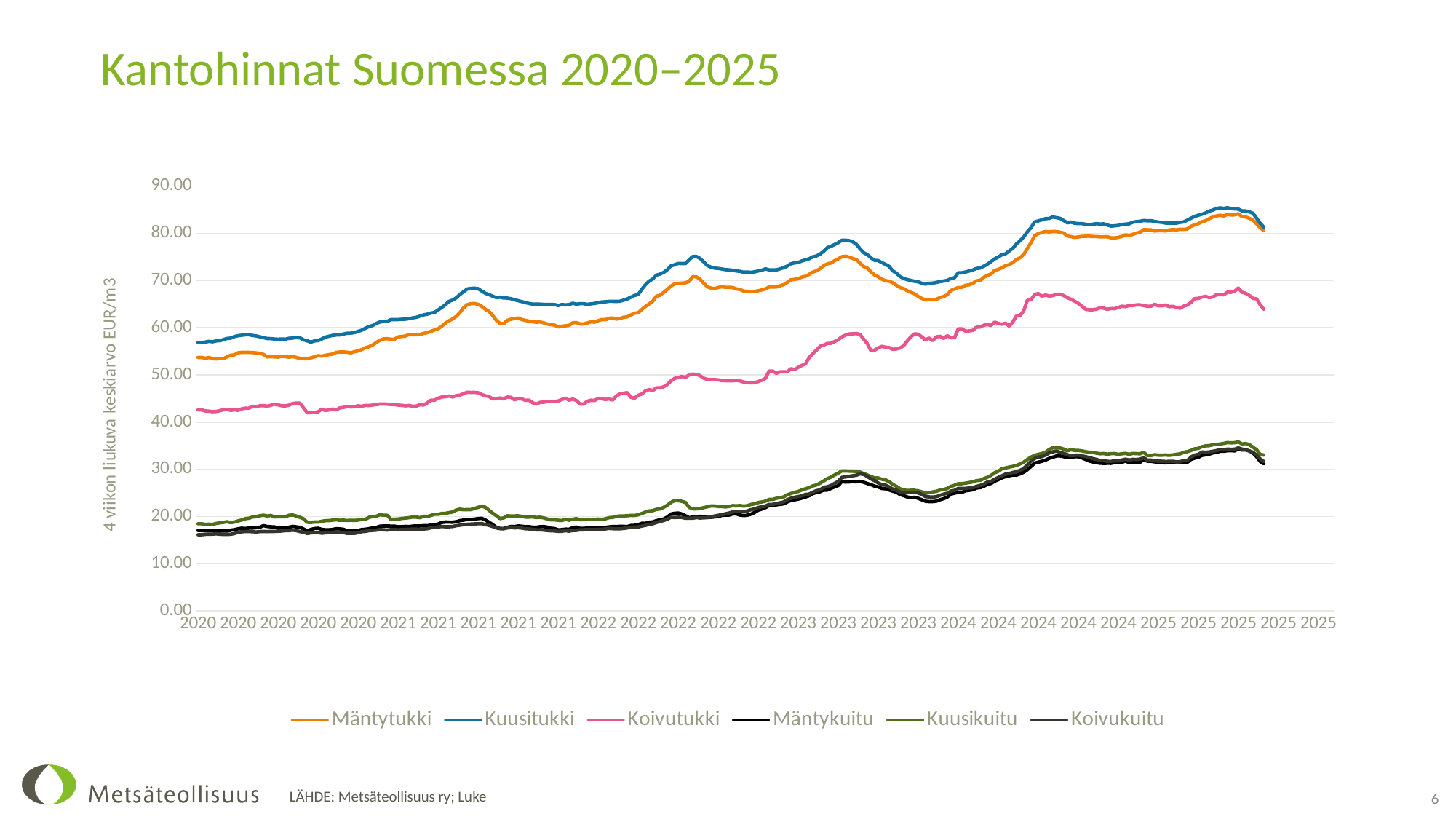
Does the Mäntykuitu series rise or fall from 2020 to 2025 overall? rises Which series has the highest values across the chart? Kuusitukki Is the value for Mäntytukki at the start of 2020 greater or less than 60? less How many series does the legend list? 6 What kind of chart is shown on the slide? line chart What is the title of the chart? Kantohinnat Suomessa 2020–2025 Is the peak value for Kuusikuitu in 2025 greater or less than 40? less What is the label of the vertical axis? 4 viikon liukuva keskiarvo EUR/m3 Which series is higher in 2022, Mäntytukki or Koivutukki? Mäntytukki Which series is higher, Koivutukki or Kuusikuitu? Koivutukki Is the value for Koivutukki at the start of 2020 greater or less than 40? greater Does the Kuusitukki series rise or fall from 2020 to 2025 overall? rises